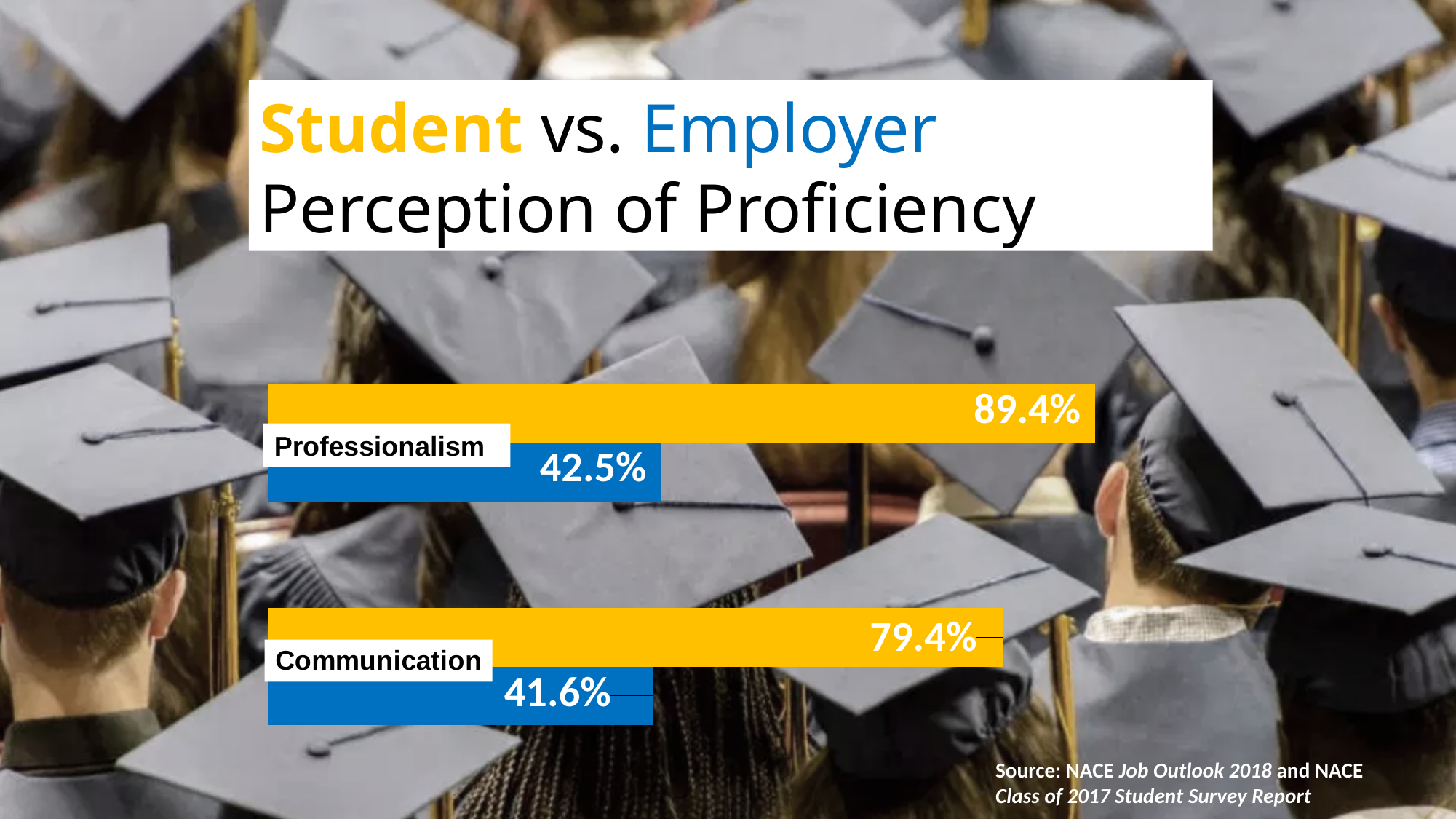
What kind of chart is shown on the slide? Bar chart How many skill categories are shown on the chart? 2 Which bar shows the lowest value on the chart? Employer, Communication What is the difference between the Student and Employer values for Professionalism? 46.9% Which is larger, the Student value for Communication or the Employer value for Professionalism? Student value for Communication Which colour represents the Employer bars on the chart? Blue What is the Employer value for Communication? 41.6% What is the Student value for Professionalism? 89.4% What is the Employer value for Professionalism? 42.5% What is the Student value for Communication? 79.4% What is the difference between the Student and Employer values for Communication? 37.8% Which bar shows the highest value on the chart? Student, Professionalism